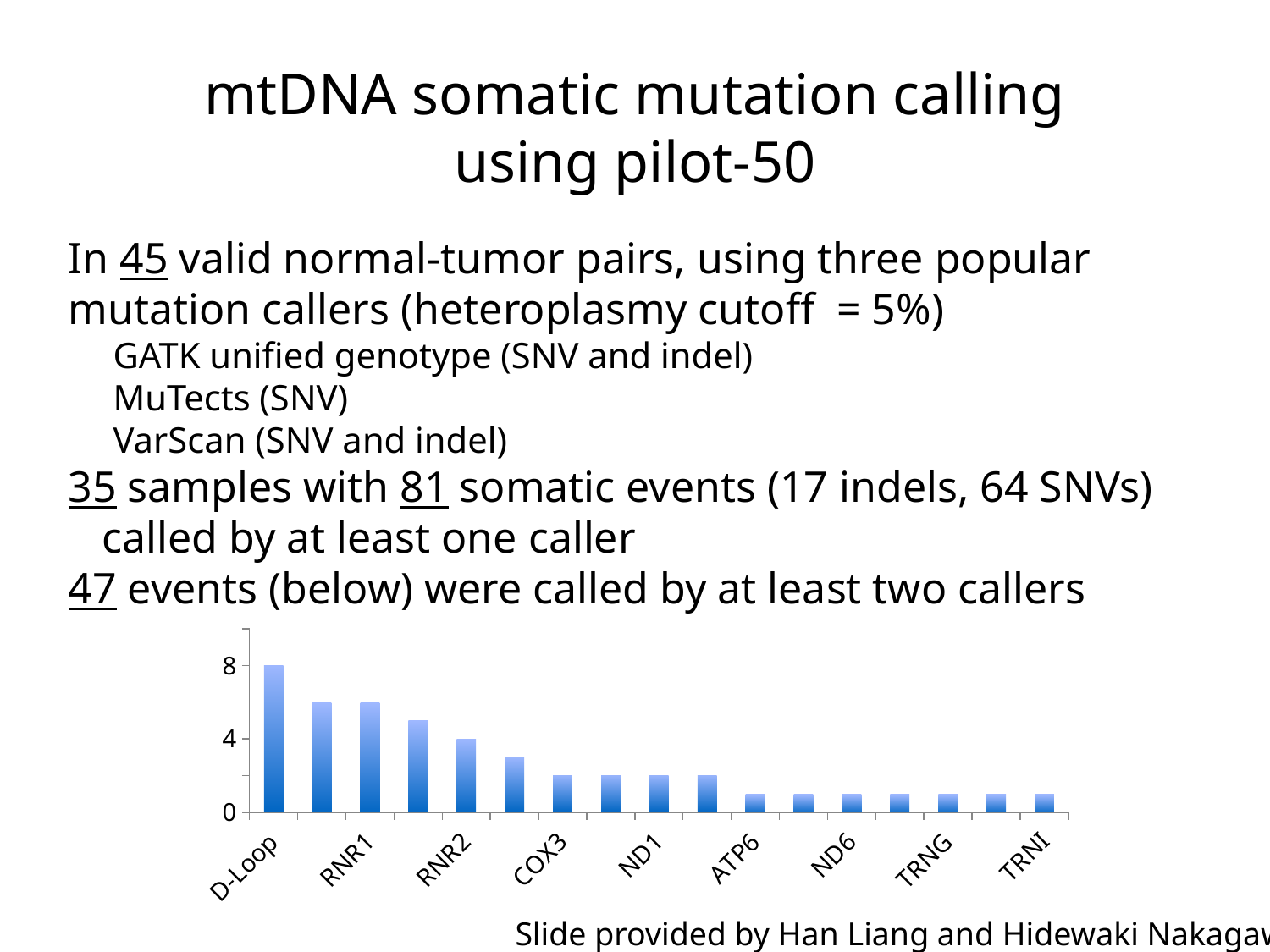
What is the label of the first category on the x axis? D-Loop What kind of chart is shown on the slide? bar chart Which is larger, the value for D-Loop or the value for RNR2? D-Loop How many bars are plotted in the chart? 17 What is the value for D-Loop? 8 Do the values rise or fall from left to right along the x axis? fall What is the value for RNR2? 4 Is the value for RNR1 greater or less than 4? greater Which category has the highest value in the chart? D-Loop What is the difference between the values for D-Loop and RNR2? 4 Is the value for ATP6 greater or less than 4? less Is the value for COX3 greater or less than 4? less